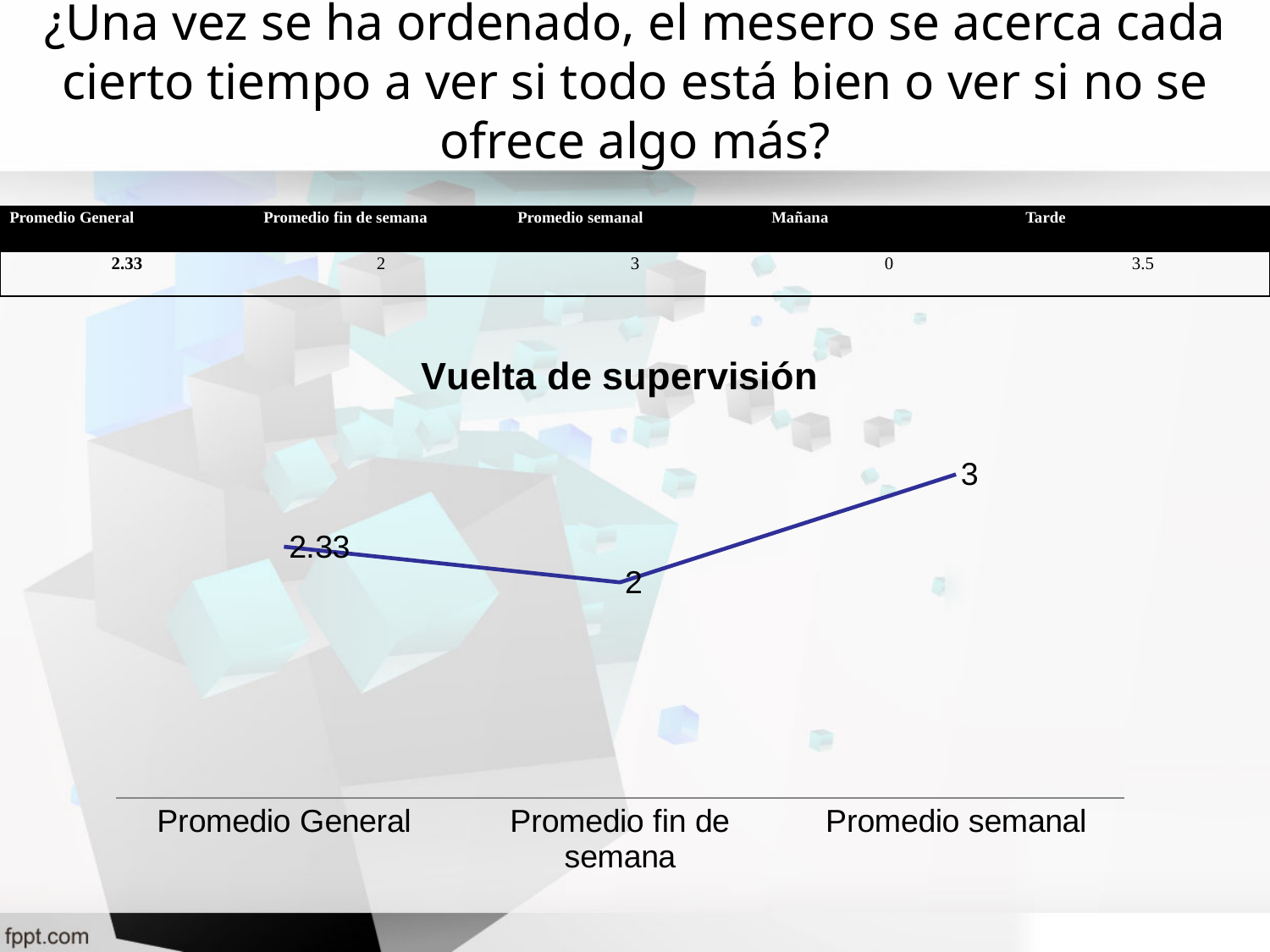
Which category has the lowest value in the chart? Promedio fin de semana What is the value for Promedio General in the chart? 2.33 What is the title of the chart? Vuelta de supervisión What is the value for Promedio semanal in the chart? 3 Does the line rise or fall between Promedio fin de semana and Promedio semanal? rise What is the value for Promedio fin de semana in the chart? 2 What kind of chart is shown on the slide? line chart What is the difference between the values for Promedio General and Promedio fin de semana? 0.33 How many categories are plotted on the x axis of the chart? 3 Which is larger, the value for Promedio General or the value for Promedio semanal? Promedio semanal What is the difference between the values for Promedio semanal and Promedio fin de semana? 1 Which category has the highest value in the chart? Promedio semanal